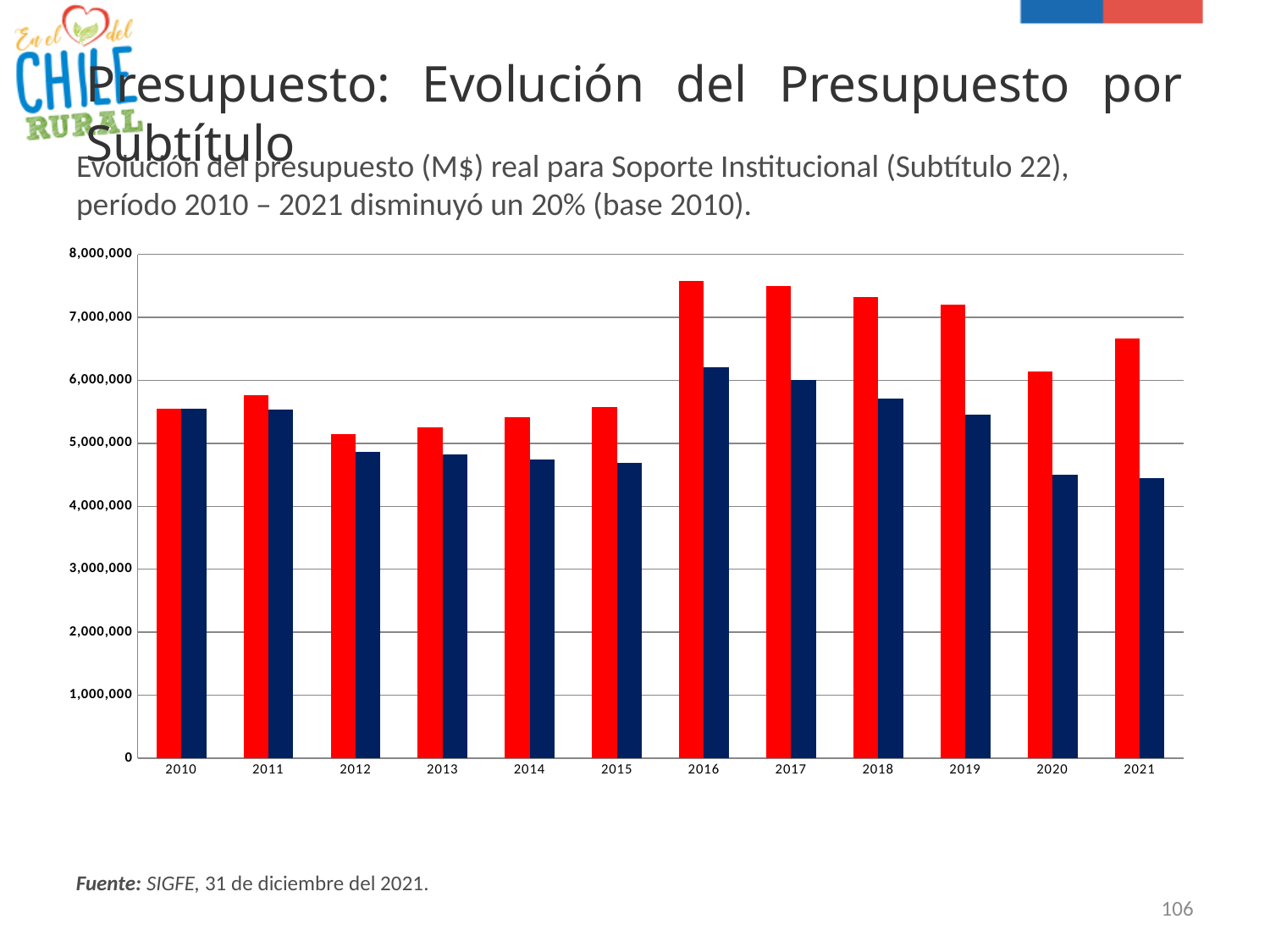
Is the red bar for 2016 greater or less than 7,000,000? greater How many years are shown along the x axis of the chart? 12 Is the dark blue bar for 2012 greater or less than 5,000,000? less Which is taller, the red bar for 2020 or the red bar for 2021? the red bar for 2021 Is the dark blue bar for 2021 greater or less than 5,000,000? less Which year has the tallest dark blue bar? 2016 What kind of chart is shown on the slide? bar chart In 2016, which bar is taller, the red bar or the dark blue bar? the red bar Which year has the tallest red bar? 2016 Do the red bars rise or fall from 2016 to 2020? fall